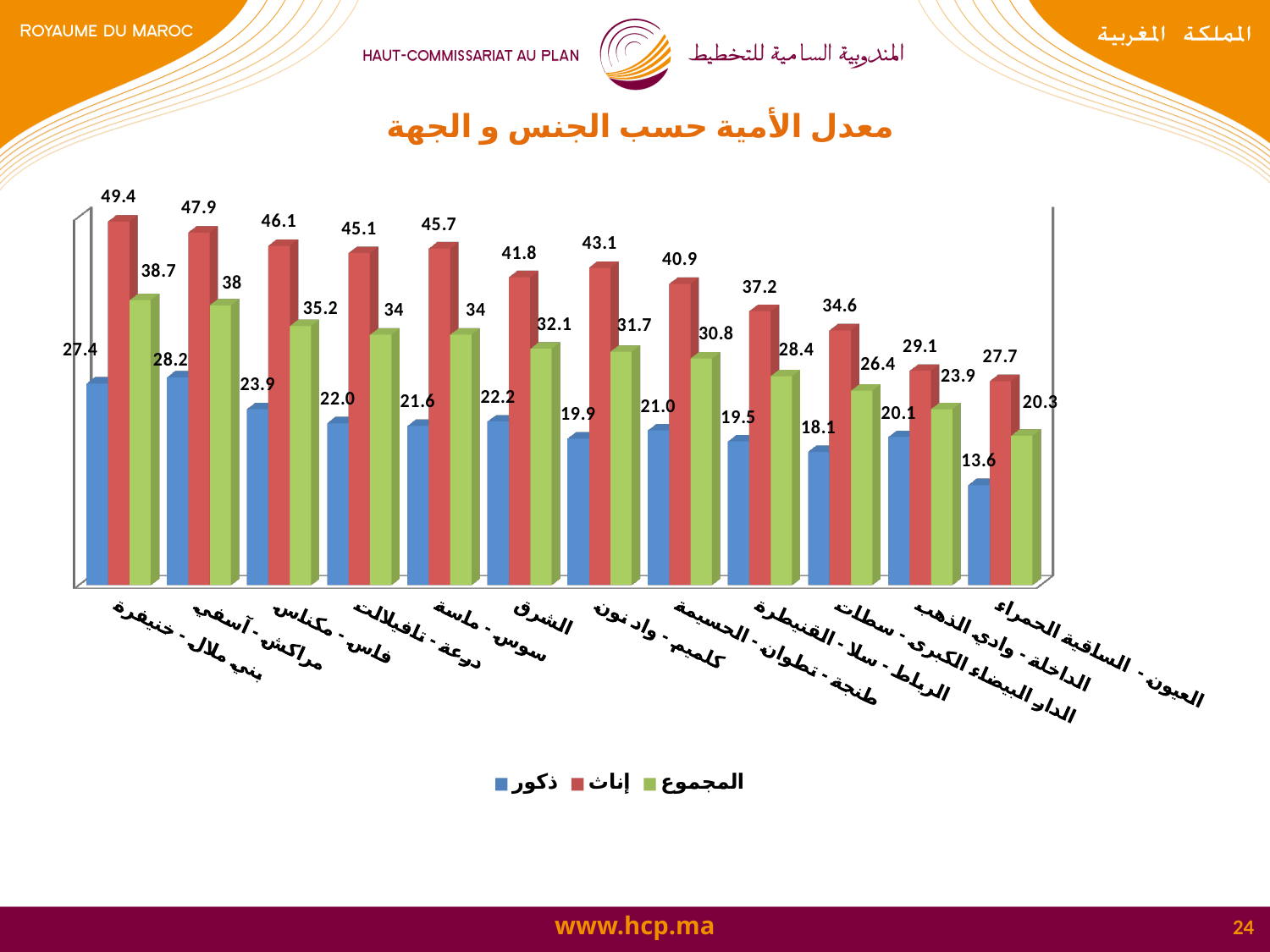
Which region has the lowest male (ذكور) illiteracy rate? العيون - الساقية الحمراء How many regions are shown on the chart? 12 Do the female (إناث) illiteracy rates generally rise or fall from left to right across the regions? Fall What kind of chart is shown on the slide? Bar chart Which colour represents the female (إناث) series in the chart? Red What is the total (المجموع) illiteracy rate for الشرق? 32.1 What is the male (ذكور) illiteracy rate for العيون - الساقية الحمراء? 13.6 What is the female (إناث) illiteracy rate for بني ملال - خنيفرة? 49.4 Which region has the highest female (إناث) illiteracy rate? بني ملال - خنيفرة What is the difference between the female and male illiteracy rates for مراكش - آسفي? 19.7 How many series does the legend list? 3 Which is larger, the total (المجموع) rate for فاس - مكناس or for درعة - تافيلالت? فاس - مكناس